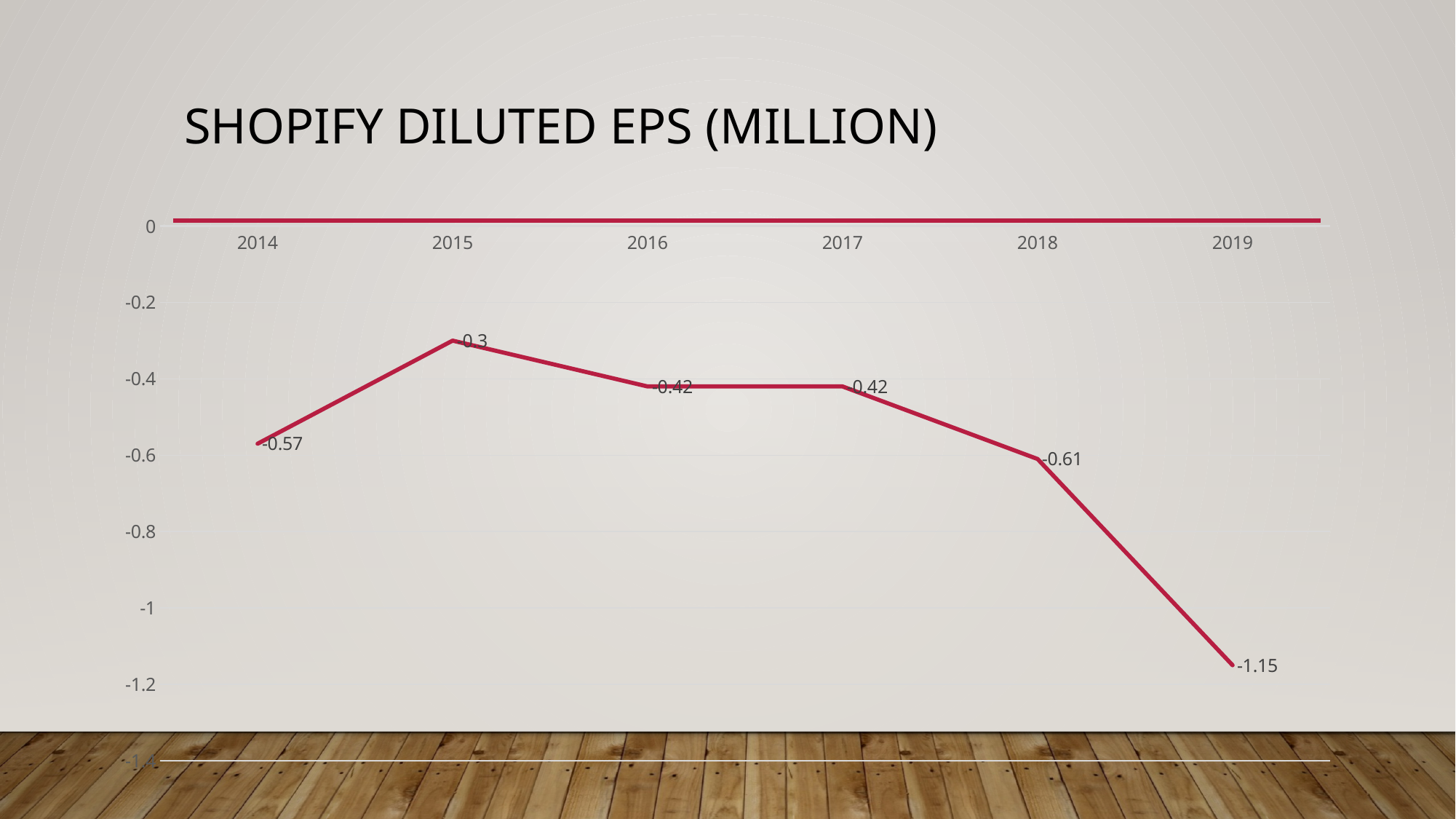
How many years are plotted on the chart? 6 What is the Shopify diluted EPS value for 2016? -0.42 What is the Shopify diluted EPS value for 2014? -0.57 What kind of chart is shown on the slide? line chart Is the value for 2015 greater or less than -0.4? greater What is the Shopify diluted EPS value for 2018? -0.61 Which year has the highest diluted EPS value? 2015 Which year has the higher diluted EPS value, 2014 or 2018? 2014 What is the Shopify diluted EPS value for 2019? -1.15 Do the values rise or fall from 2017 to 2019? fall What is the difference between the 2018 value and the 2019 value? 0.54 Which year has the lowest diluted EPS value? 2019